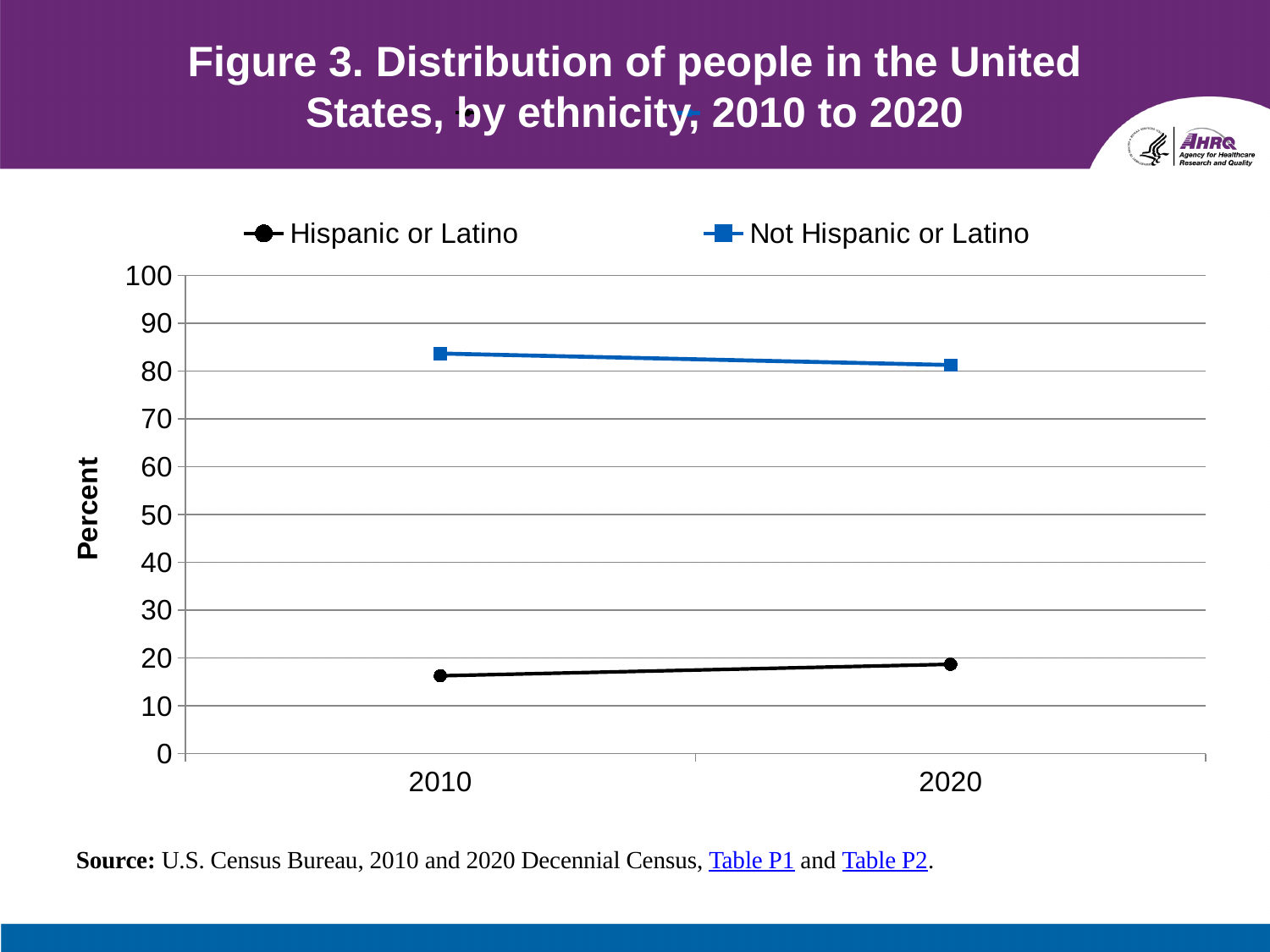
Is the value for Not Hispanic or Latino in 2010 greater or less than 80? greater How many series does the legend list? 2 Is the value for Hispanic or Latino in 2010 greater or less than 20? less What is the label on the y axis? Percent Is the value for Hispanic or Latino in 2020 greater or less than 10? greater Does the Not Hispanic or Latino line rise or fall from 2010 to 2020? fall What kind of chart is shown on the slide? line chart Which series is drawn in blue? Not Hispanic or Latino Does the Hispanic or Latino line rise or fall from 2010 to 2020? rise Which series has the higher value in 2020, Hispanic or Latino or Not Hispanic or Latino? Not Hispanic or Latino How many years are plotted on the x axis? 2